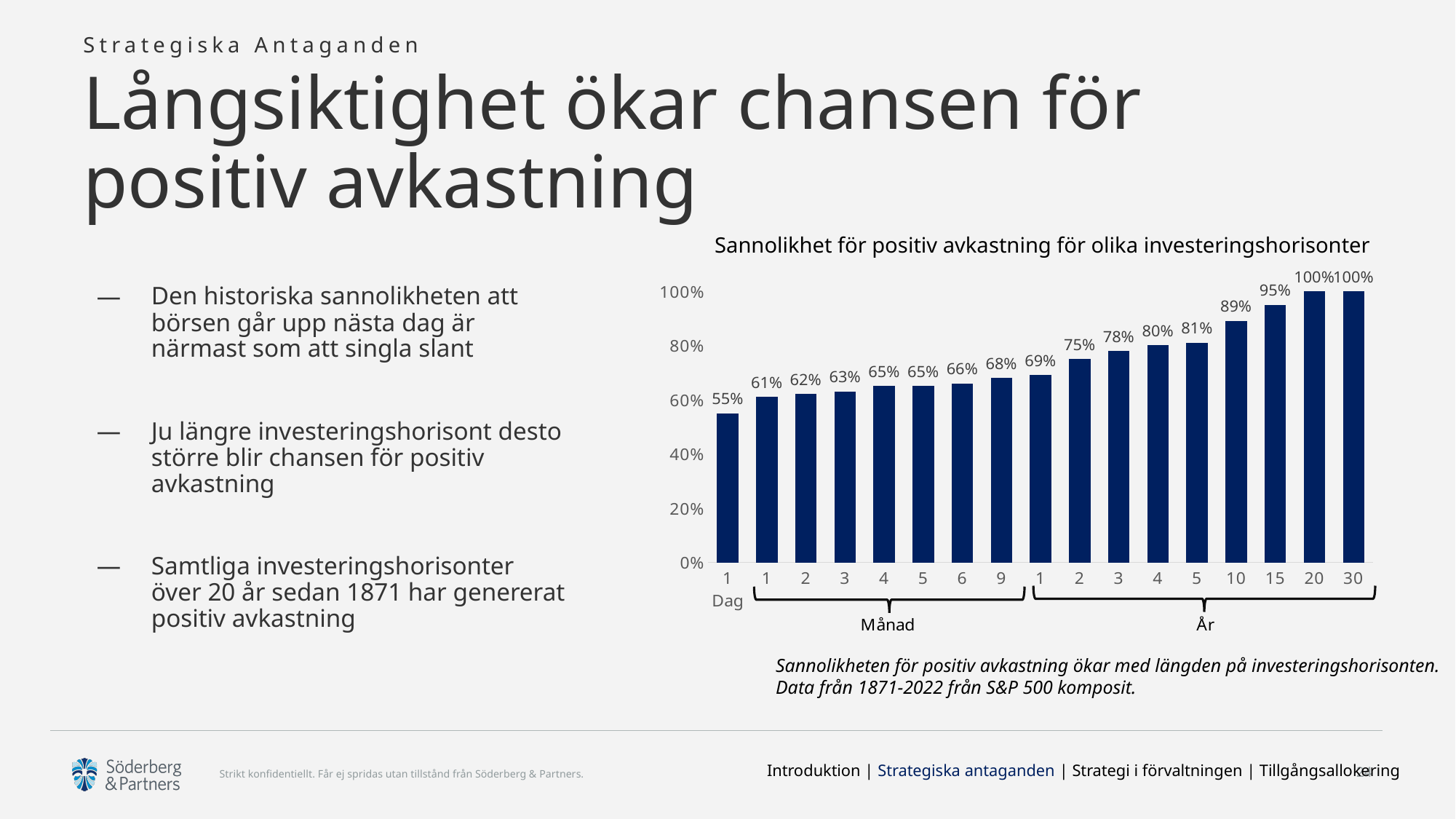
What is the difference in probability between the 15-year and the 5-year horizons? 14% What is the title of the chart? Sannolikhet för positiv avkastning för olika investeringshorisonter What is the probability of positive return for a 1-year (1 År) horizon? 69% What is the difference in probability between the 1-month and the 1-day horizons? 6% What type of chart is shown on the slide? Bar chart What is the probability of positive return for a 10-year (10 År) horizon? 89% What is the probability of positive return for a 9-month (9 Månad) horizon? 68% How many bars are plotted in the chart? 17 Do the values rise or fall as the investment horizon lengthens along the x axis? Rise Which investment horizon has the lowest probability of positive return? 1 Dag What is the probability of positive return for a 1-day investment horizon? 55% Which has a higher probability of positive return: the 3-year horizon or the 6-month horizon? 3-year horizon